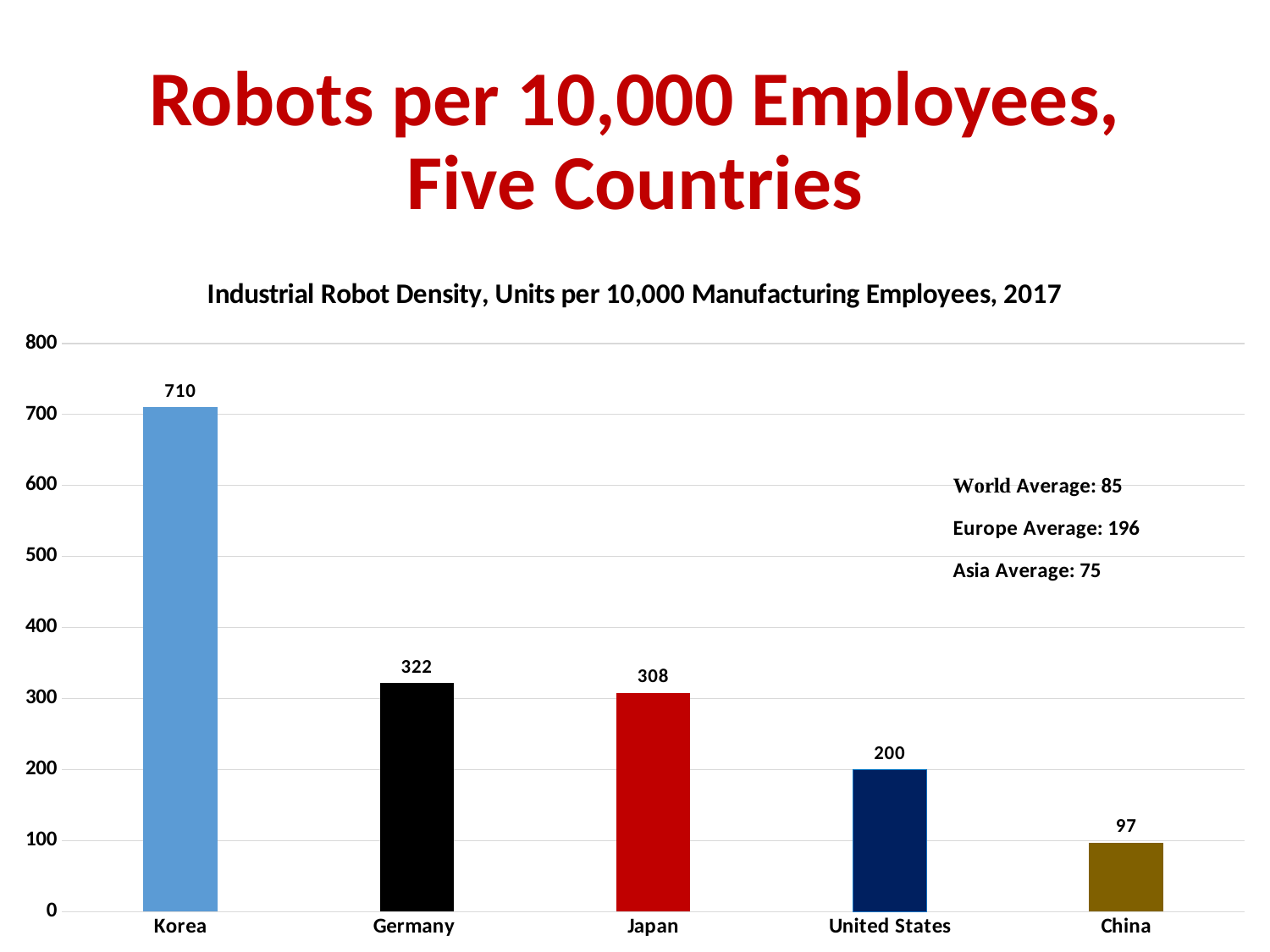
How many countries are shown in the chart? 5 Is the value for China greater or less than 100? less Which has a larger value, Japan or the United States? Japan Which country has the lowest robot density? China What is the difference between Korea's value and Germany's value? 388 What is the difference between Germany's value and Japan's value? 14 What is the value shown for the United States? 200 What is the Europe Average stated on the chart? 196 What kind of chart is shown on the slide? bar chart What is the value shown for China? 97 What is the industrial robot density value for Korea? 710 Which country has the highest robot density? Korea